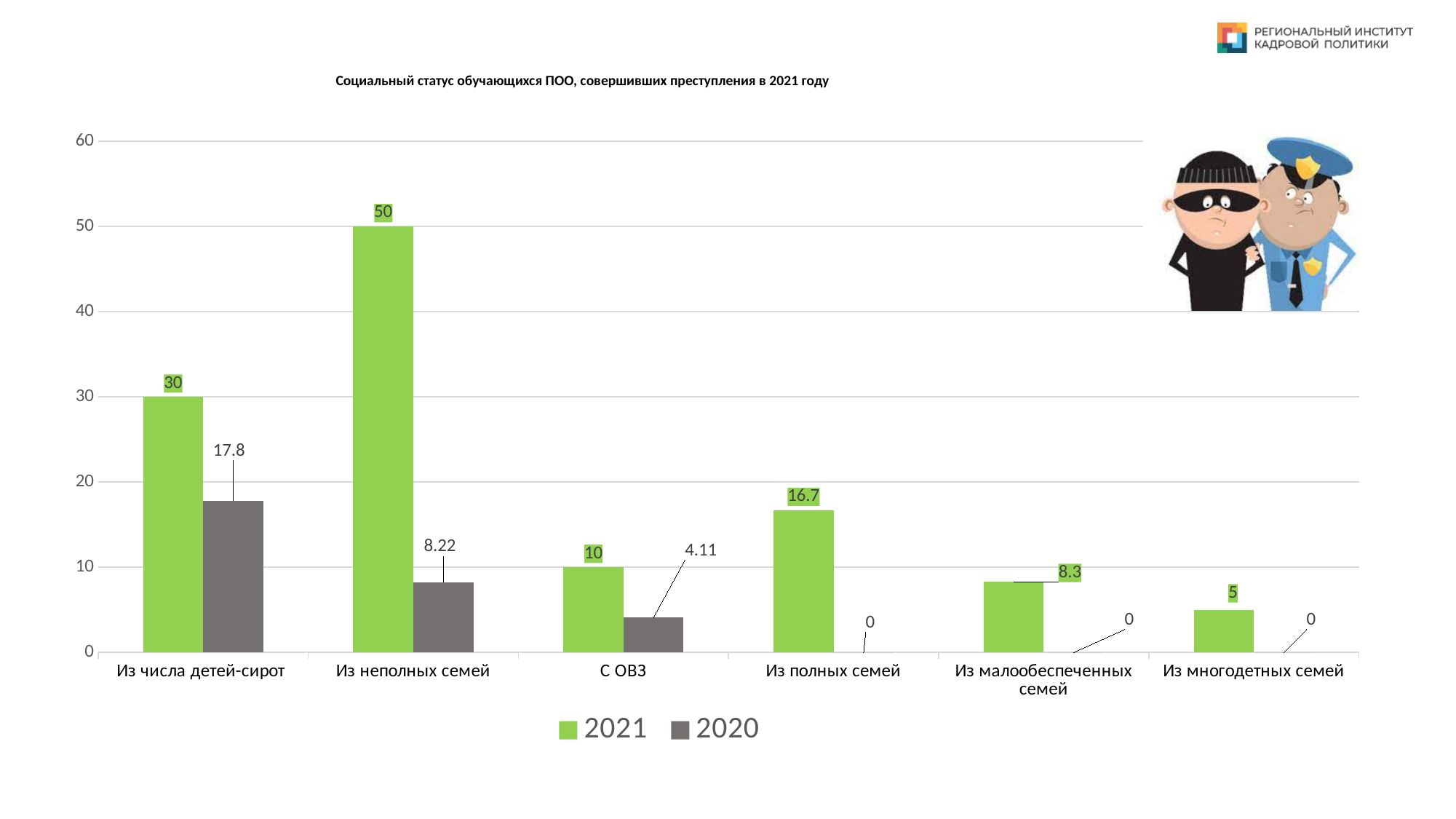
Which category has the highest 2021 value? Из неполных семей How many categories are shown on the x axis? 6 What type of chart is shown on the slide? Bar chart Is the 2021 value for «Из неполных семей» greater or less than 40? greater Which category has the lowest 2021 value? Из многодетных семей What is the 2021 value for «Из малообеспеченных семей»? 8.3 Which is larger: the 2021 value for «Из полных семей» or the 2021 value for «С ОВЗ»? Из полных семей What is the difference between the 2021 and 2020 values for «Из числа детей-сирот»? 12.2 How many series does the legend list? 2 What is the 2020 value for «Из числа детей-сирот»? 17.8 What is the 2020 value for «С ОВЗ»? 4.11 What is the 2021 value for «Из неполных семей»? 50